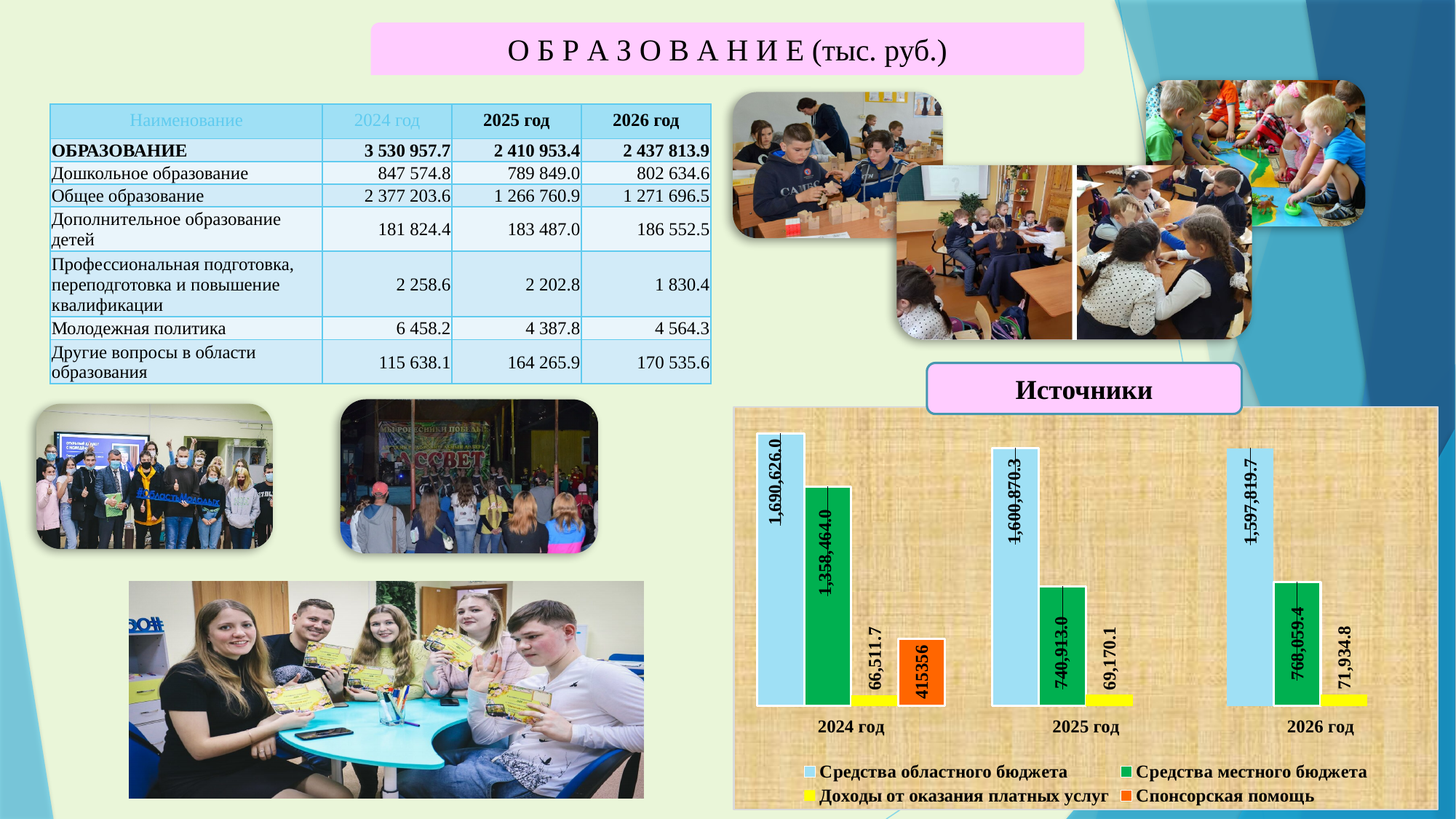
How many series does the legend of the 'Источники' chart list? 4 How many year categories are shown on the x axis of the 'Источники' chart? 3 In the 'Источники' chart, which year has the highest value for Средства местного бюджета? 2024 год In the 'Источники' chart, what is the value of Спонсорская помощь for 2024 год? 415356 In the 'Источники' chart, does the value of Средства местного бюджета rise or fall from 2024 год to 2025 год? Fall In the 'Источники' chart, what is the difference between Средства областного бюджета and Средства местного бюджета in 2026 год? 829,760.3 In the 'Источники' chart, what is the value of Средства областного бюджета for 2024 год? 1,690,626.0 What kind of chart is the 'Источники' chart? Bar chart In the 'Источники' chart, what is the value of Доходы от оказания платных услуг for 2026 год? 71,934.8 In the 'Источники' chart, which year has the lowest value for Доходы от оказания платных услуг? 2024 год In the 'Источники' chart, what is the value of Средства местного бюджета for 2025 год? 740,913.0 In the 'Источники' chart, which is larger in 2025 год: Средства областного бюджета or Средства местного бюджета? Средства областного бюджета